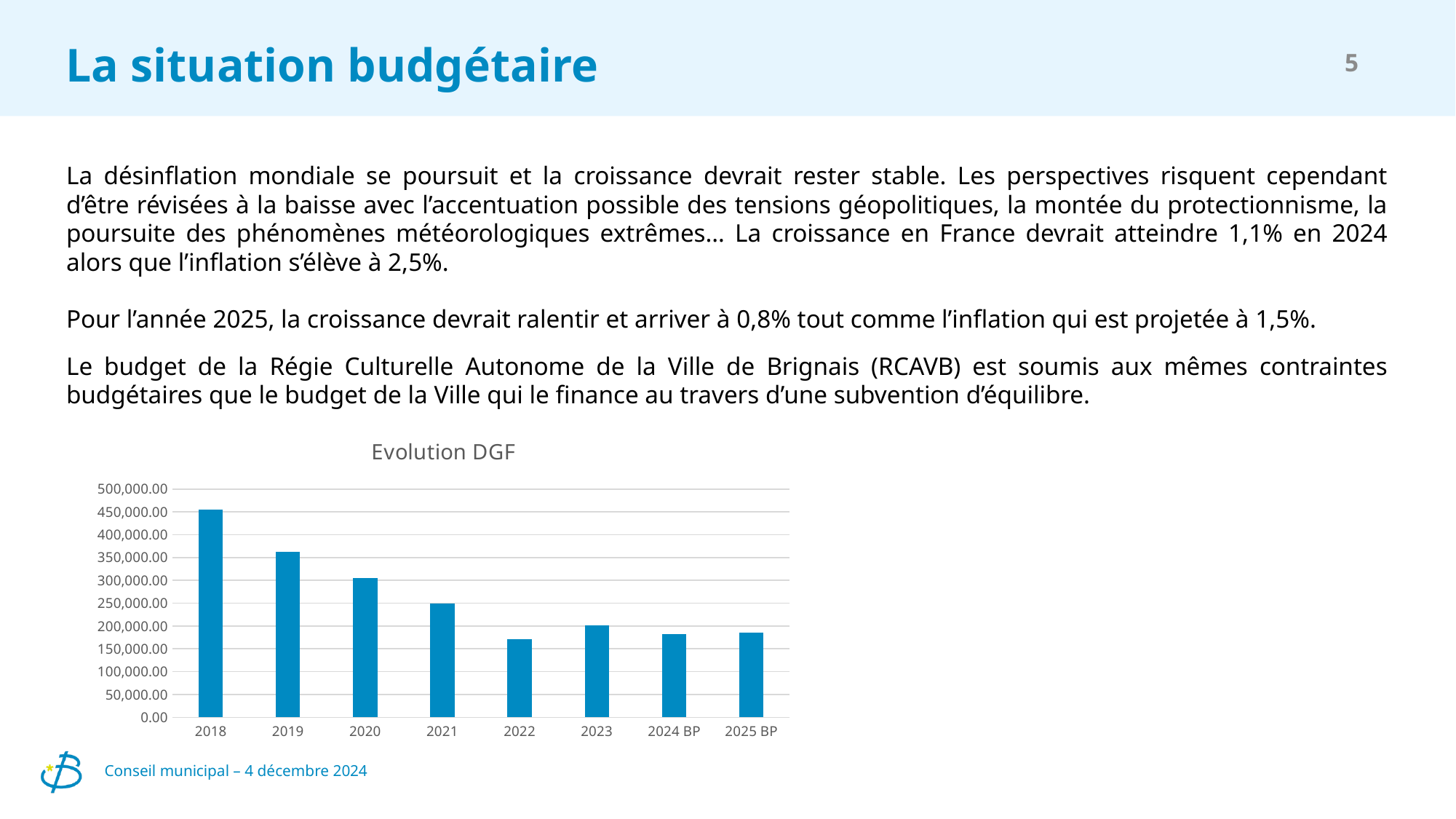
How many categories are shown on the x axis of the chart? 8 Which is larger, the value for 2019 or the value for 2020? 2019 Do the values rise or fall from 2018 to 2022? fall Which category has the lowest value in the Evolution DGF chart? 2022 Which is larger, the value for 2022 or the value for 2023? 2023 What is the title of the chart? Evolution DGF Which year has the highest value in the Evolution DGF chart? 2018 Is the value for 2024 BP greater or less than 200,000.00? less Is the value for 2021 greater or less than 300,000.00? less What kind of chart is shown on the slide? bar chart Is the value for 2022 greater or less than 200,000.00? less